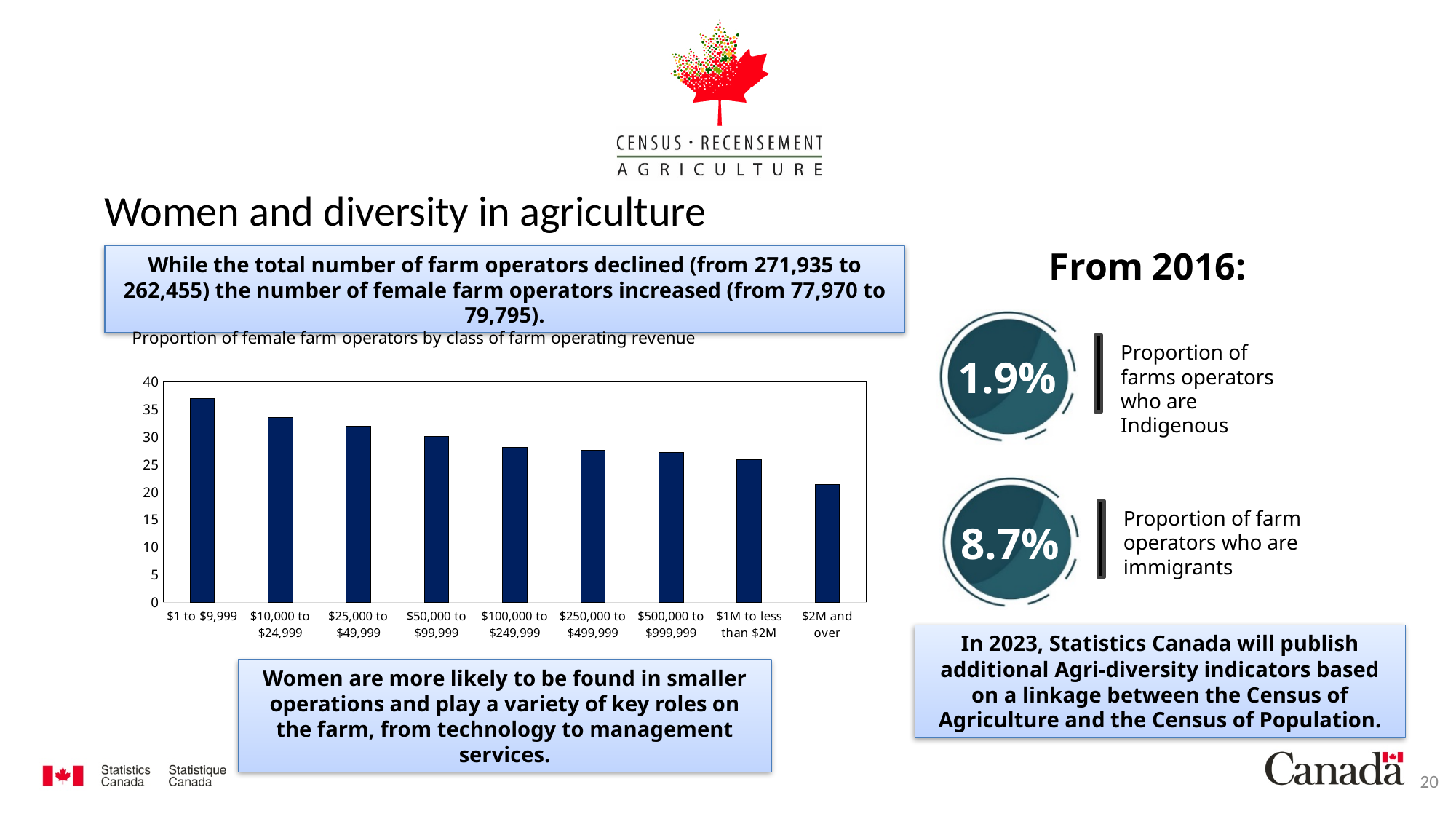
Is the value for $10,000 to $24,999 greater or less than 30? greater How many revenue classes are shown on the x axis of the chart? 9 What kind of chart is shown on the slide? bar chart Is the value for $100,000 to $249,999 greater or less than 30? less Is the value for $2M and over greater or less than 25? less Which is larger, the value for $1 to $9,999 or the value for $2M and over? $1 to $9,999 Which revenue class has the lowest proportion of female farm operators? $2M and over What is the title of the chart? Proportion of female farm operators by class of farm operating revenue Do the values rise or fall as revenue class increases along the x axis? fall Which revenue class has the highest proportion of female farm operators? $1 to $9,999